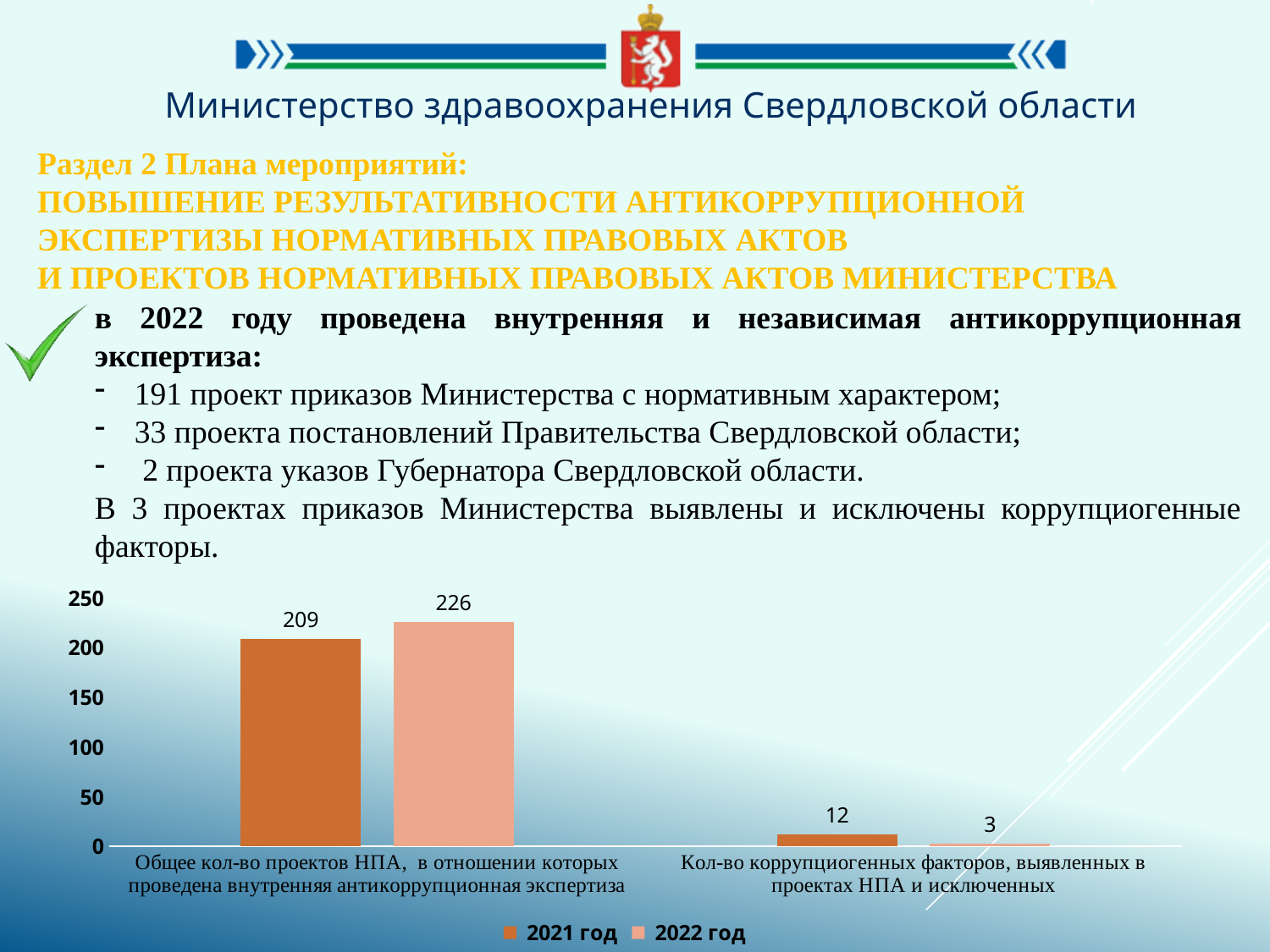
Which bar in the chart has the highest value? 2022 год, Общее кол-во проектов НПА, в отношении которых проведена внутренняя антикоррупционная экспертиза (226) Which series has the larger value for 'Общее кол-во проектов НПА, в отношении которых проведена внутренняя антикоррупционная экспертиза': 2021 год or 2022 год? 2022 год What is the value for 2021 год for 'Общее кол-во проектов НПА, в отношении которых проведена внутренняя антикоррупционная экспертиза'? 209 What is the value for 2022 год for 'Кол-во коррупциогенных факторов, выявленных в проектах НПА и исключенных'? 3 How many categories are shown on the x axis of the chart? 2 Which series has the larger value for 'Кол-во коррупциогенных факторов, выявленных в проектах НПА и исключенных': 2021 год or 2022 год? 2021 год By how much did the total number of NPA drafts examined increase from 2021 год to 2022 год? 17 How many series does the chart legend list? 2 What is the value for 2022 год for 'Общее кол-во проектов НПА, в отношении которых проведена внутренняя антикоррупционная экспертиза'? 226 What type of chart is shown on the slide? Bar chart What is the value for 2021 год for 'Кол-во коррупциогенных факторов, выявленных в проектах НПА и исключенных'? 12 What is the difference between the 2021 год and 2022 год values for corruption-related factors identified and excluded? 9